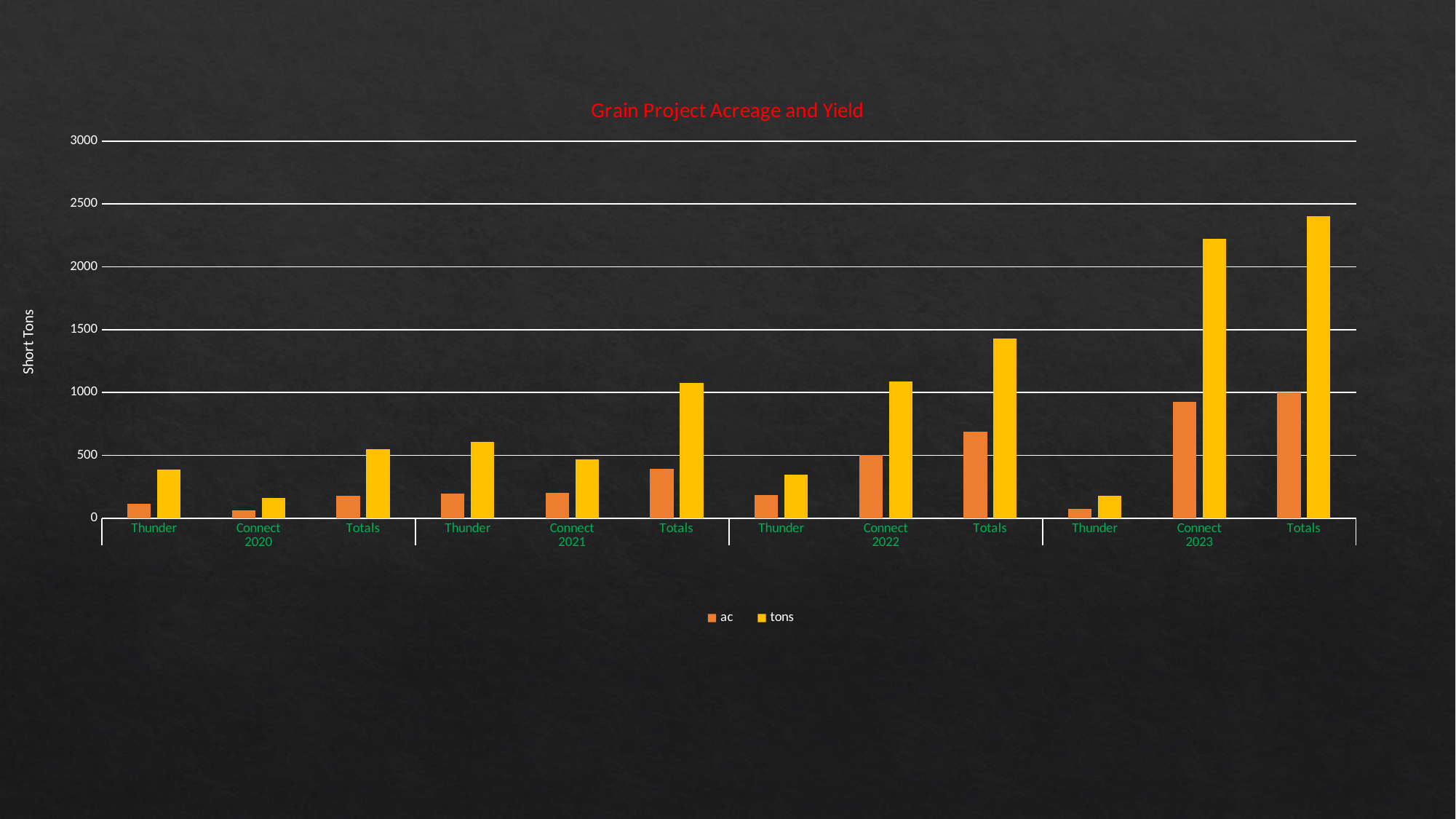
How many categories are plotted along the x axis? 12 Which is larger, the tons value for Thunder 2021 or the tons value for Thunder 2022? Thunder 2021 Is the tons value for Totals 2023 greater or less than 2000? greater Which category has the highest tons value? Totals 2023 What is the title of the chart? Grain Project Acreage and Yield What kind of chart is shown on the slide? bar chart How many series does the legend list? 2 Is the tons value for Totals 2022 greater or less than 1500? less Is the tons value for Thunder 2020 greater or less than 500? less Which category has the lowest tons value? Connect 2020 Do the tons values for the Totals categories rise or fall from 2020 to 2023? rise